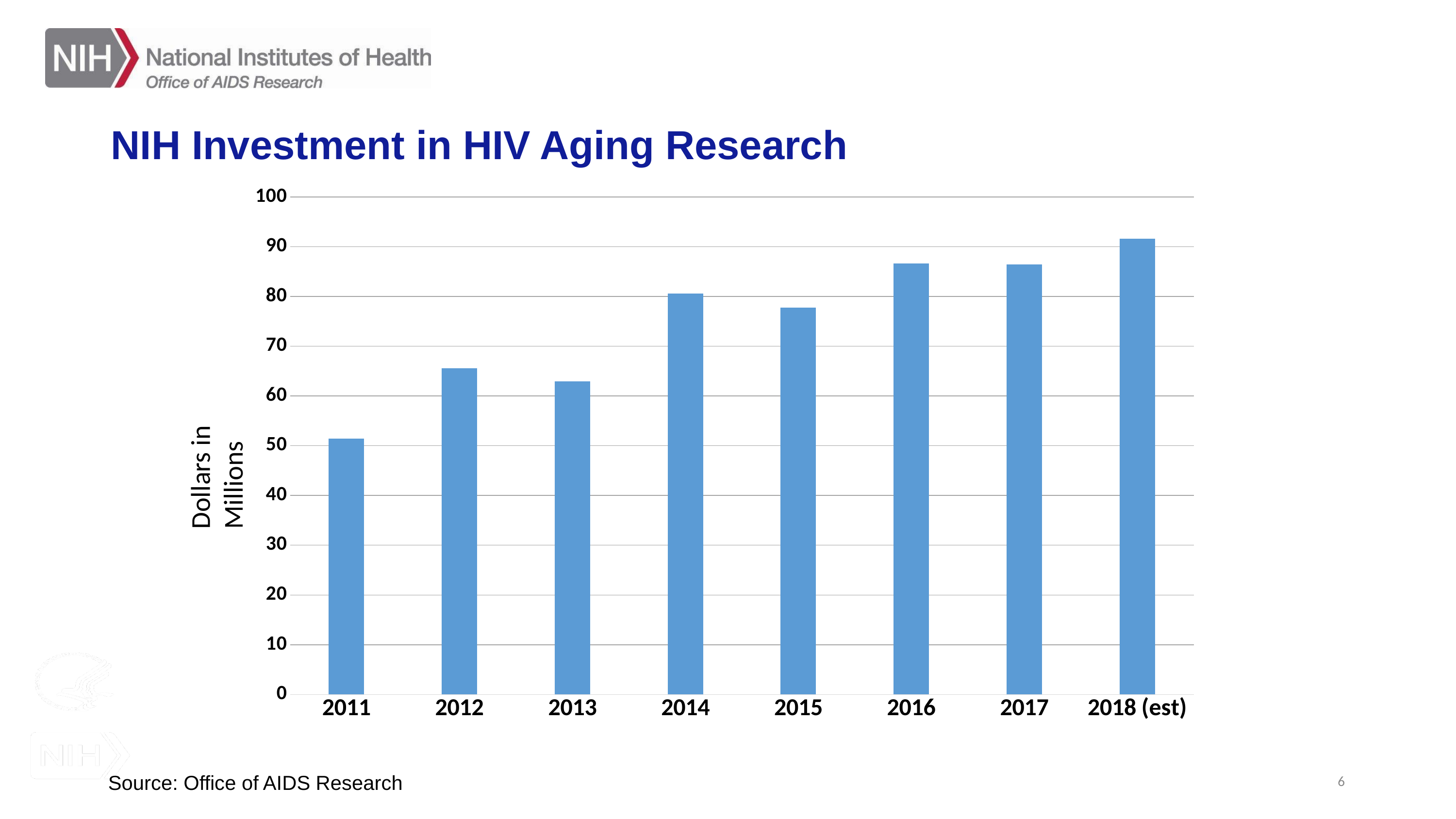
What kind of chart is shown on the slide? bar chart How many years are shown on the x axis of the chart? 8 Is the value for 2013 greater or less than 70? less Is the value for 2015 greater or less than 80? less Which year has the lowest NIH investment in HIV aging research? 2011 Do the values generally rise or fall from 2011 to 2018 (est)? rise Is the value for 2018 (est) greater or less than 90? greater What is the label on the y axis of the chart? Dollars in Millions Which year has the larger value, 2012 or 2013? 2012 Which year has the highest NIH investment in HIV aging research? 2018 (est)